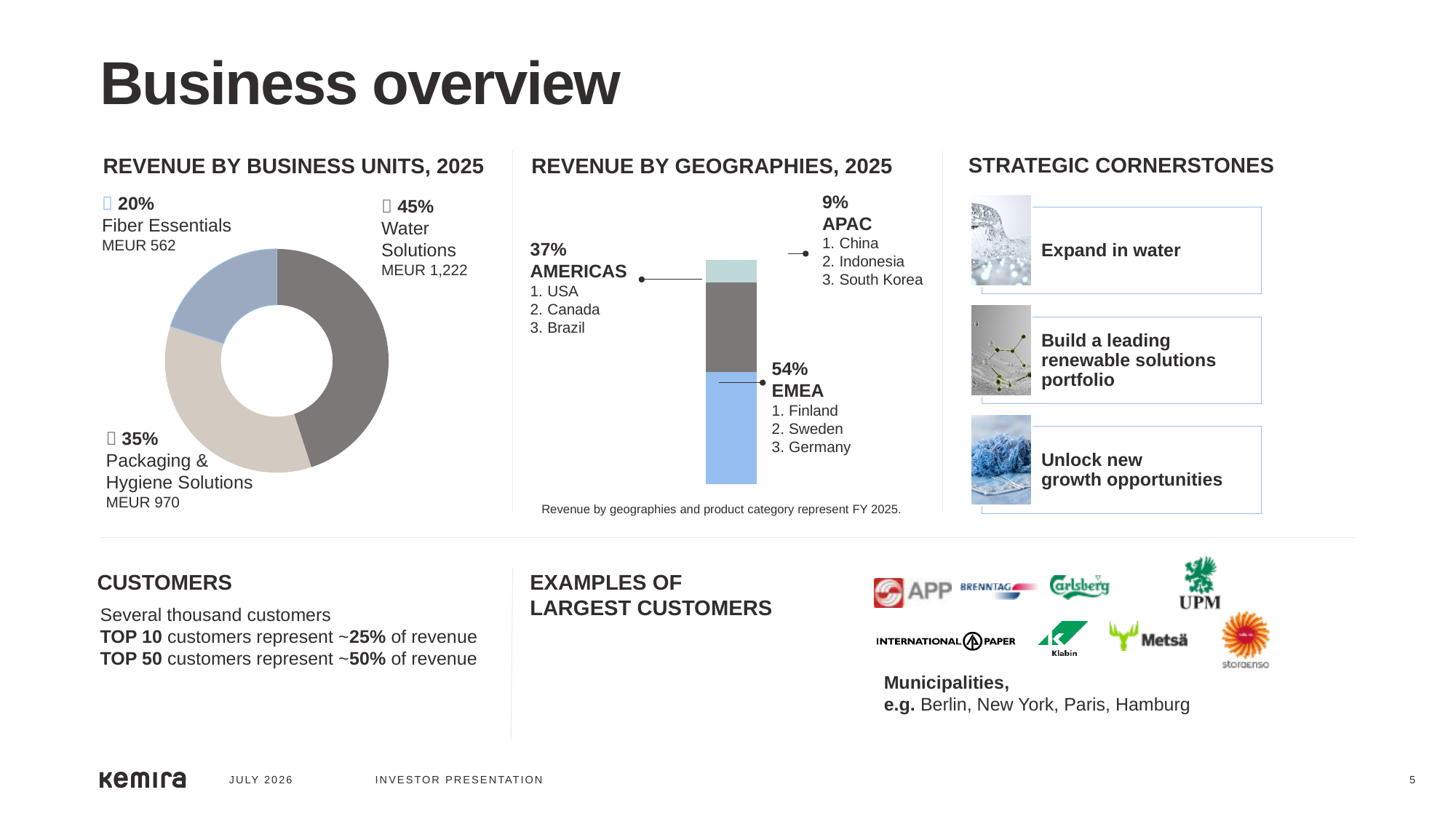
In the 'Revenue by geographies, 2025' chart, which region has the largest share of revenue? EMEA What type of chart is used for 'Revenue by business units, 2025'? Donut chart In the 'Revenue by geographies, 2025' chart, what share of revenue comes from EMEA? 54% In the 'Revenue by business units, 2025' chart, what is the revenue of Packaging & Hygiene Solutions in MEUR? MEUR 970 In the 'Revenue by business units, 2025' chart, which business unit has the smallest share of revenue? Fiber Essentials In the 'Revenue by geographies, 2025' chart, which countries are listed under Americas? USA, Canada, Brazil In the 'Revenue by business units, 2025' chart, what share of revenue does Water Solutions represent? 45% In the 'Revenue by business units, 2025' chart, what is the difference in revenue between Water Solutions and Fiber Essentials in MEUR? MEUR 660 In the 'Revenue by geographies, 2025' chart, what is the difference in percentage points between the Americas and APAC shares? 28 percentage points In the 'Revenue by geographies, 2025' chart, what share of revenue comes from APAC? 9% In the 'Revenue by business units, 2025' chart, how many business units are shown? 3 In the 'Revenue by business units, 2025' chart, which business unit has the largest share of revenue? Water Solutions